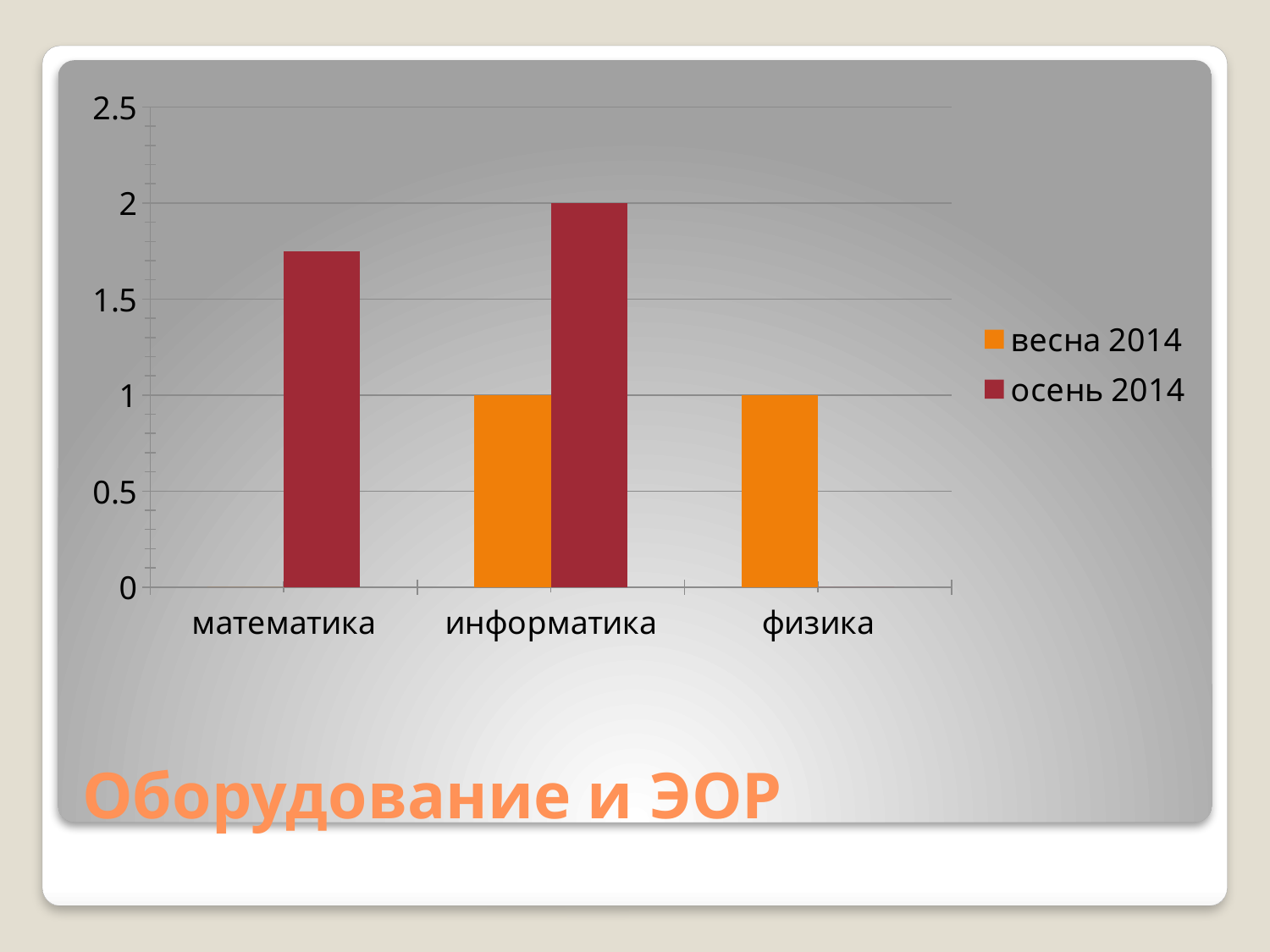
What kind of chart is shown on the slide? bar chart What is the value for физика in the весна 2014 series? 1 What is the value for информатика in the весна 2014 series? 1 Which category has the highest value in the осень 2014 series? информатика How many categories are shown on the x axis? 3 What is the title of the slide? Оборудование и ЭОР What is the value for информатика in the осень 2014 series? 2 What is the difference between the осень 2014 and весна 2014 values for информатика? 1 How many series does the legend list? 2 Is the value for математика in the осень 2014 series greater or less than 1.5? greater Which is larger for информатика: the весна 2014 value or the осень 2014 value? осень 2014 Is the value for математика in the осень 2014 series greater or less than 2? less